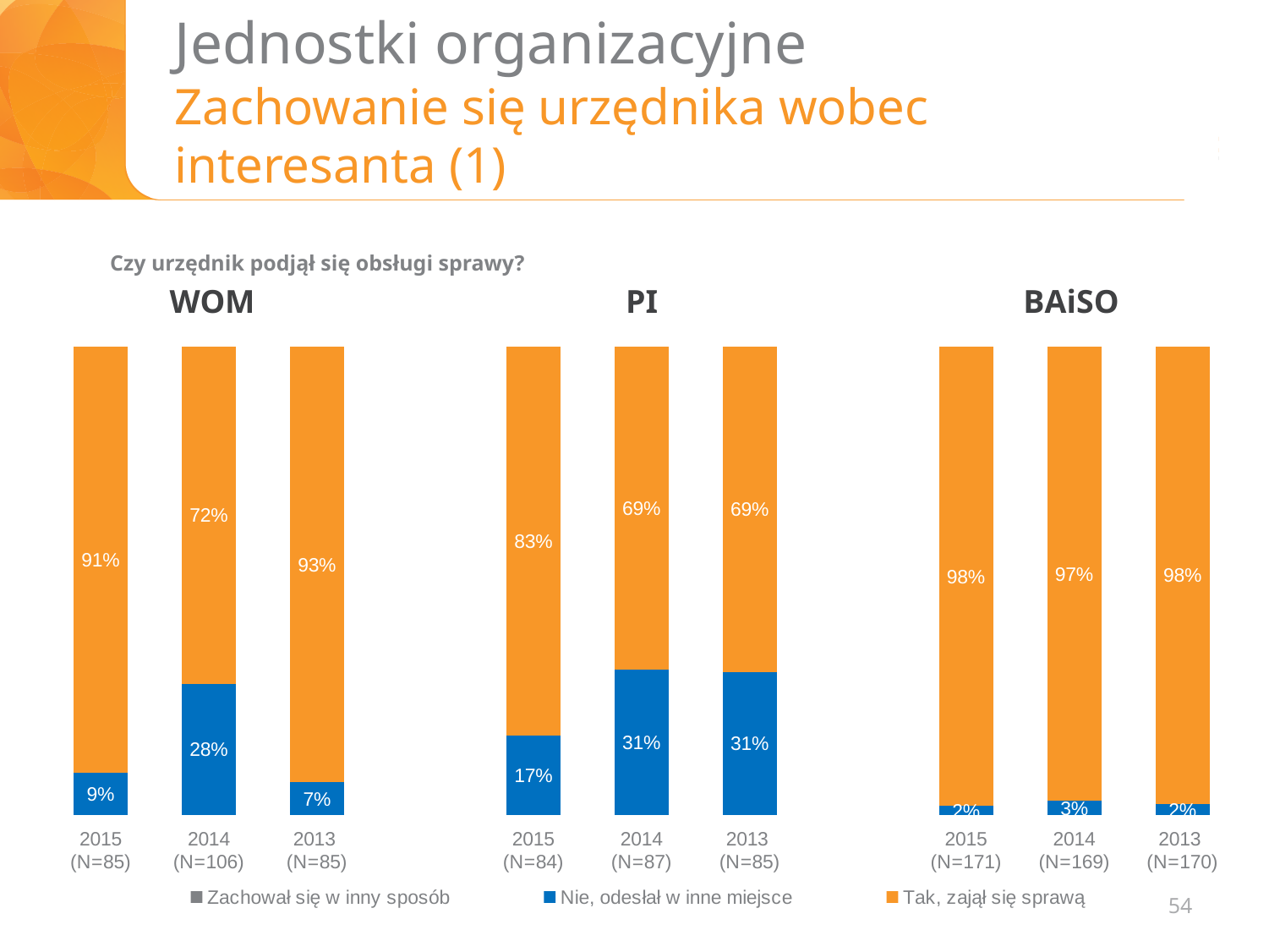
In the WOM chart, which year has the highest value for "Tak, zajął się sprawą"? 2013 (N=85) In the WOM chart, which year has the lowest value for "Nie, odesłał w inne miejsce"? 2013 (N=85) What kind of chart is the BAiSO chart? Stacked bar chart In the PI chart, what is the total of the stacked bar for 2013 (N=85)? 100% In the WOM chart, which is larger: the "Nie, odesłał w inne miejsce" value for 2015 (N=85) or for 2014 (N=106)? 2014 (N=106) In the PI chart, what is the difference between the "Tak, zajął się sprawą" values for 2015 (N=84) and 2014 (N=87)? 14 percentage points In the WOM chart, what is the value for "Tak, zajął się sprawą" in 2015 (N=85)? 91% In the WOM chart, what is the value for "Nie, odesłał w inne miejsce" in 2014 (N=106)? 28% How many series does the legend list? 3 In the BAiSO chart, what is the value for "Nie, odesłał w inne miejsce" in 2014 (N=169)? 3% How many year categories does the PI chart show? 3 In the PI chart, what is the value for "Tak, zajął się sprawą" in 2015 (N=84)? 83%